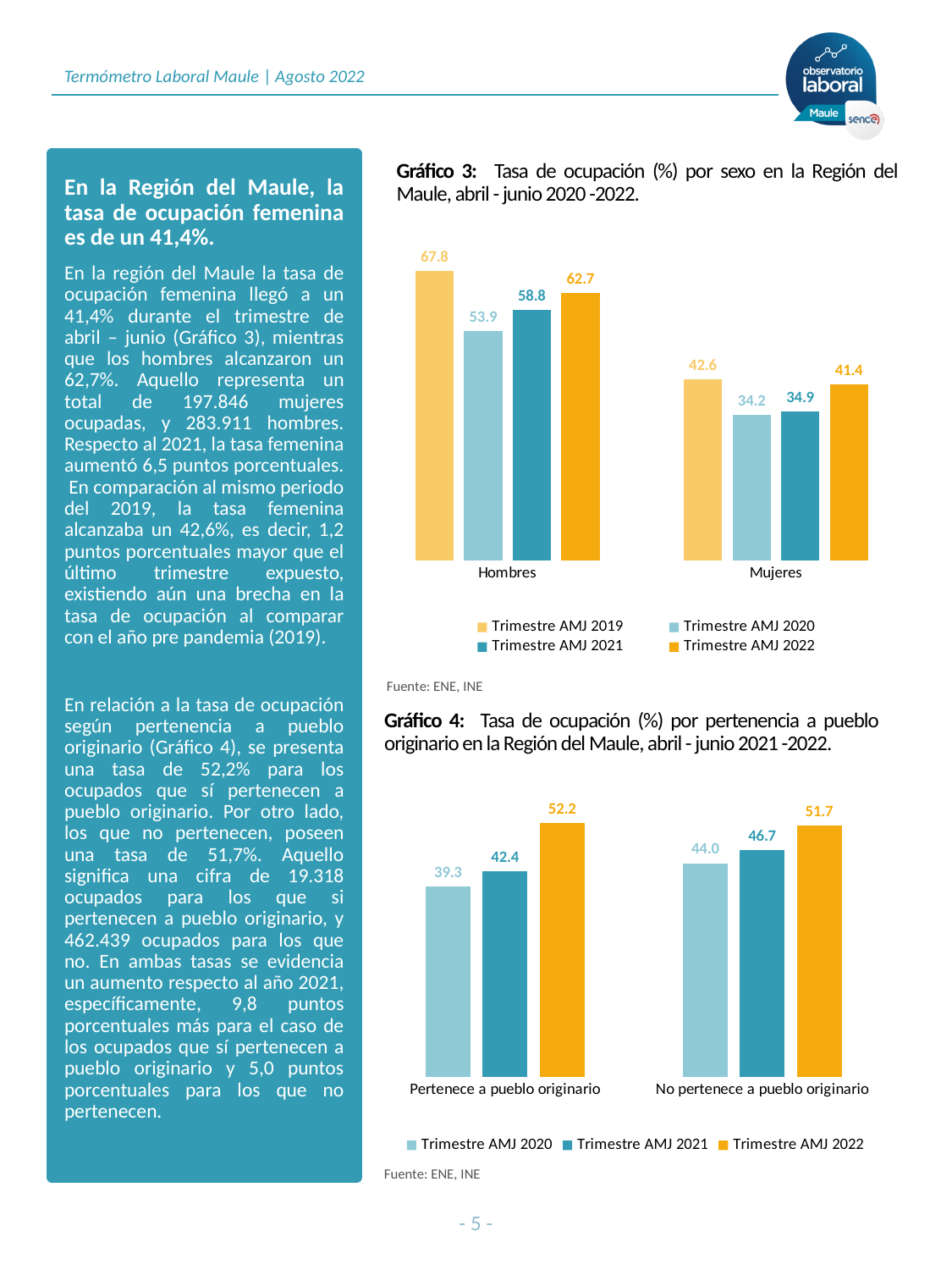
In Gráfico 3, which series has the lowest value for Mujeres? Trimestre AMJ 2020 In Gráfico 3, which series has the highest value for Hombres? Trimestre AMJ 2019 In Gráfico 3, what is the value for Mujeres in Trimestre AMJ 2020? 34.2 In Gráfico 4, what is the value for No pertenece a pueblo originario in Trimestre AMJ 2020? 44.0 What kind of chart is Gráfico 4? bar chart In Gráfico 4, what is the value for Pertenece a pueblo originario in Trimestre AMJ 2021? 42.4 In Gráfico 3, what is the difference between the Hombres and Mujeres values for Trimestre AMJ 2022? 21.3 In Gráfico 4, do the values for No pertenece a pueblo originario rise or fall from Trimestre AMJ 2020 to Trimestre AMJ 2022? rise In Gráfico 3, what is the value for Hombres in Trimestre AMJ 2022? 62.7 In Gráfico 3, how many series does the legend list? 4 In Gráfico 4, which is larger for Trimestre AMJ 2022: Pertenece a pueblo originario or No pertenece a pueblo originario? Pertenece a pueblo originario In Gráfico 4, what is the difference between the Trimestre AMJ 2022 and Trimestre AMJ 2020 values for Pertenece a pueblo originario? 12.9